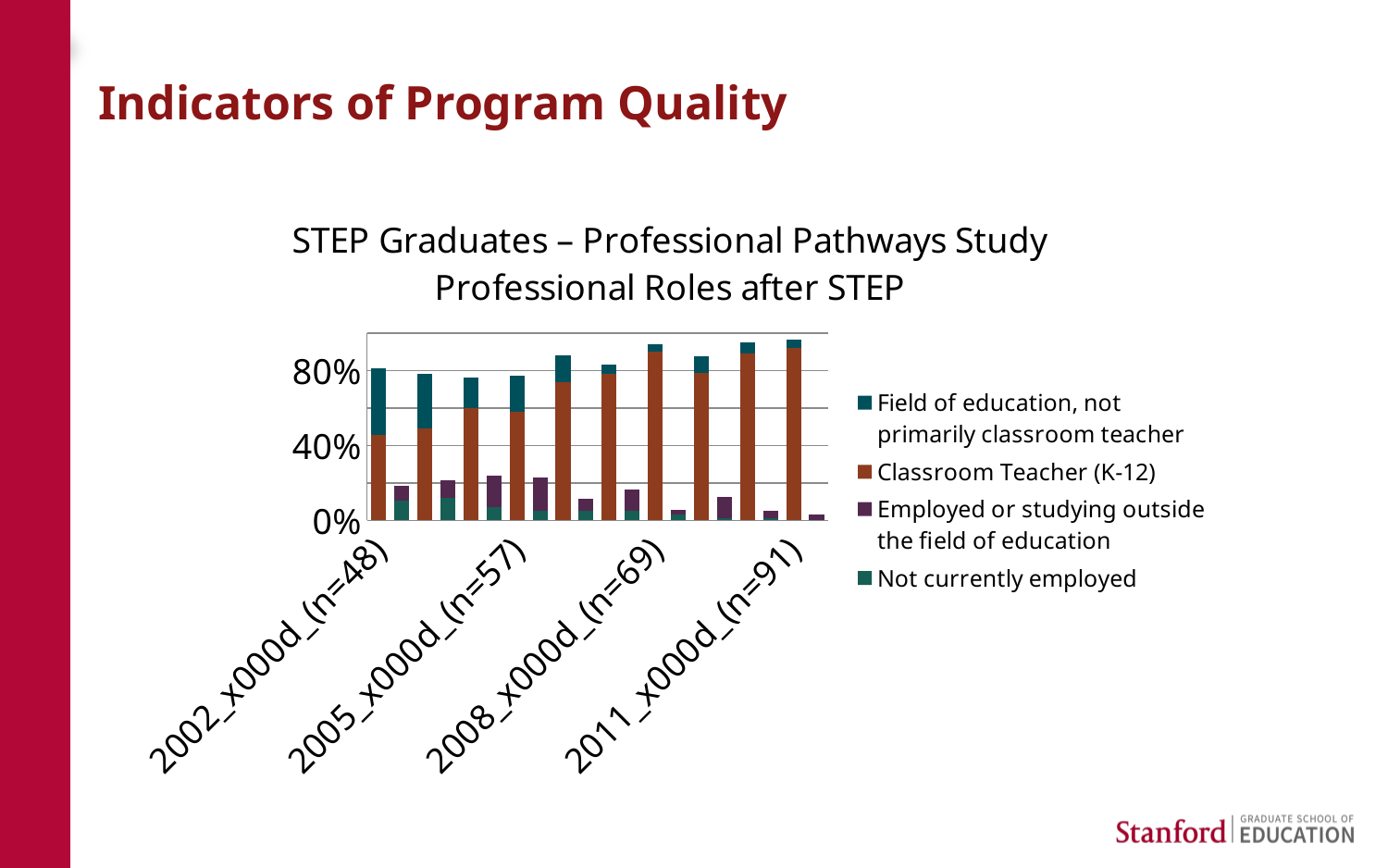
Which legend entry is shown in brown/orange? Classroom Teacher (K-12) Does the 'Classroom Teacher (K-12)' share rise or fall from 2002 to 2011? rise Which year has the larger 'Classroom Teacher (K-12)' segment, 2002 (n=48) or 2011 (n=91)? 2011 (n=91) Is the total of the tall stacked bar for 2008 (n=69) greater or less than 80%? greater Is the 'Classroom Teacher (K-12)' segment for 2011 (n=91) greater or less than 80%? greater How many series does the chart's legend list? 4 Is the value of the 'Employed or studying outside the field of education' bar for 2011 (n=91) greater or less than 40%? less What is the title of the chart? STEP Graduates – Professional Pathways Study Professional Roles after STEP Does the 'Field of education, not primarily classroom teacher' share rise or fall from 2002 to 2011? fall What kind of chart is shown on the slide? Stacked bar chart